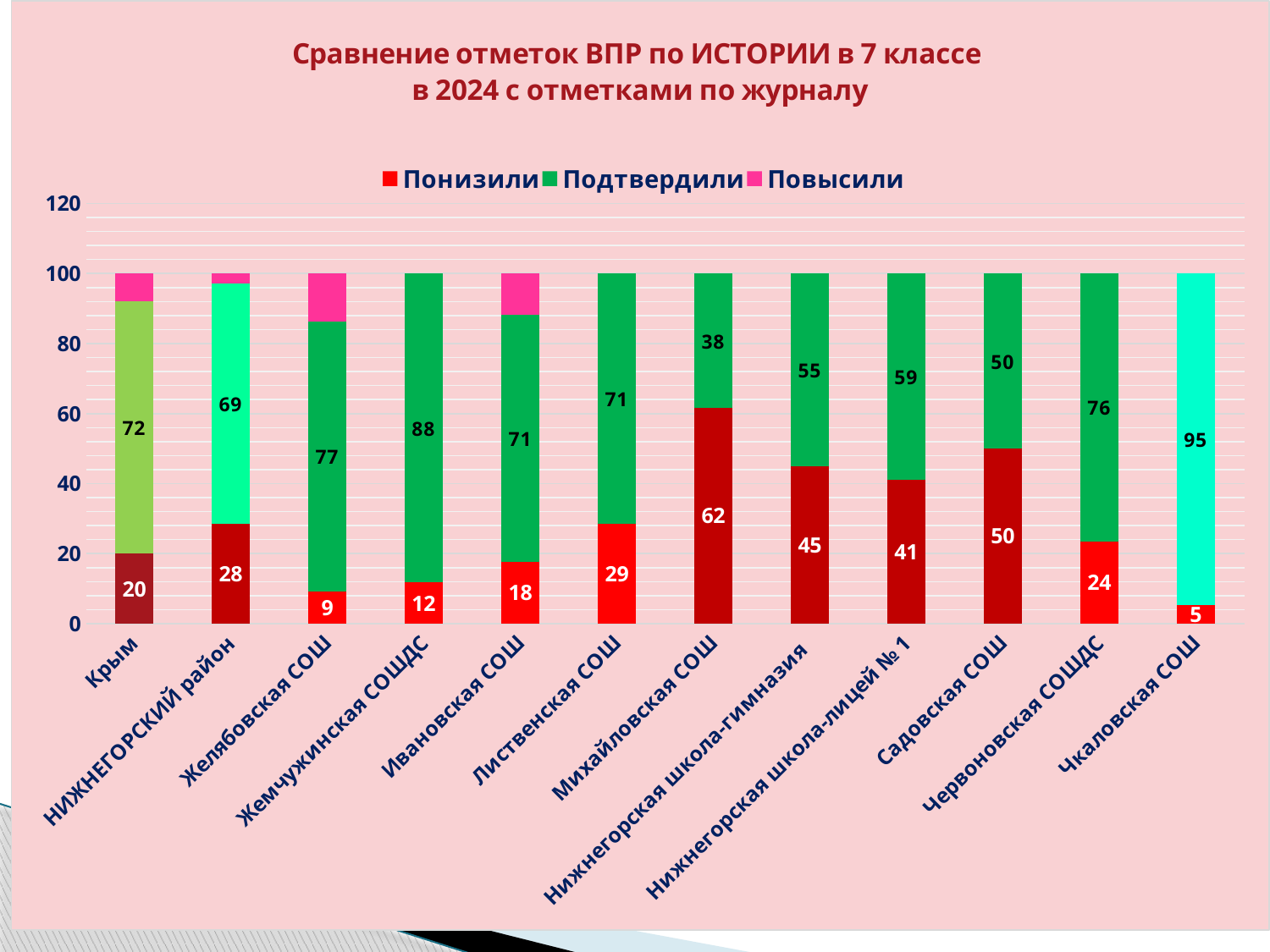
What is the value of Подтвердили for Чкаловская СОШ? 95 How many series does the legend list? 3 What is the total of the stacked bar for Садовская СОШ? 100 Which is larger, the Понизили value for Садовская СОШ or for Червоновская СОШДС? Садовская СОШ How many categories are shown on the x axis? 12 What type of chart is shown on the slide? Stacked bar chart Is the Повысили value for Крым greater or less than 20? less What is the value of Понизили for НИЖНЕГОРСКИЙ район? 28 Which category has the highest value for Понизили? Михайловская СОШ What is the difference between the Понизили values for Михайловская СОШ and Чкаловская СОШ? 57 Which category has the lowest value for Подтвердили? Михайловская СОШ What is the value of Понизили for Михайловская СОШ? 62